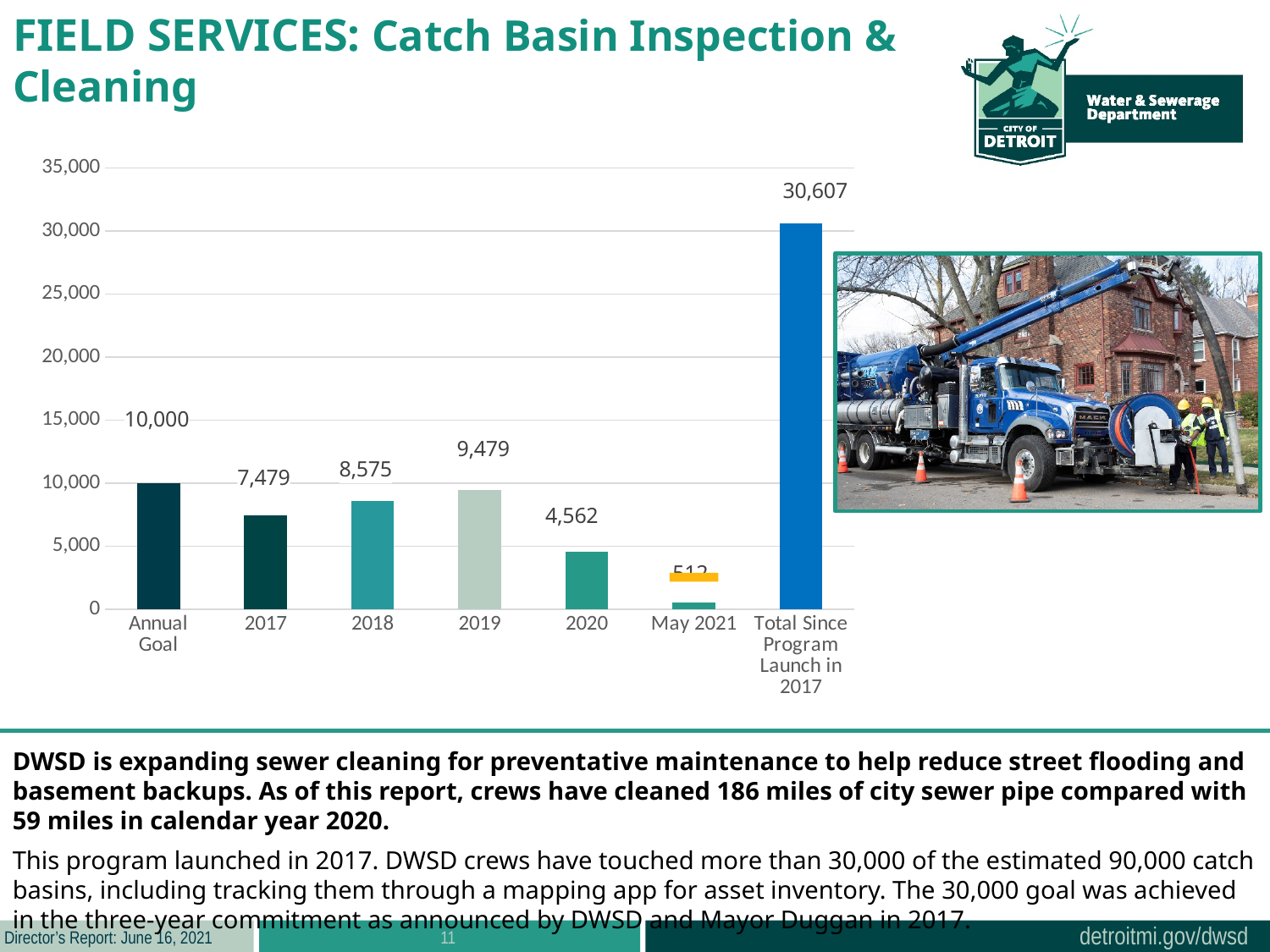
Do the values rise or fall from 2017 to 2019? rise Which category has the highest value? Total Since Program Launch in 2017 What is the value of the Annual Goal bar? 10,000 What value is shown for 2018? 8,575 Which is larger, the value for 2018 or the value for 2020? 2018 What is the difference between the 2019 and 2018 values? 904 What is the value for Total Since Program Launch in 2017? 30,607 What value is shown for 2020? 4,562 What value is shown for 2019? 9,479 By how much does the 2017 value fall short of the Annual Goal? 2,521 How many categories are shown on the x axis? 7 Which category has the lowest value? May 2021